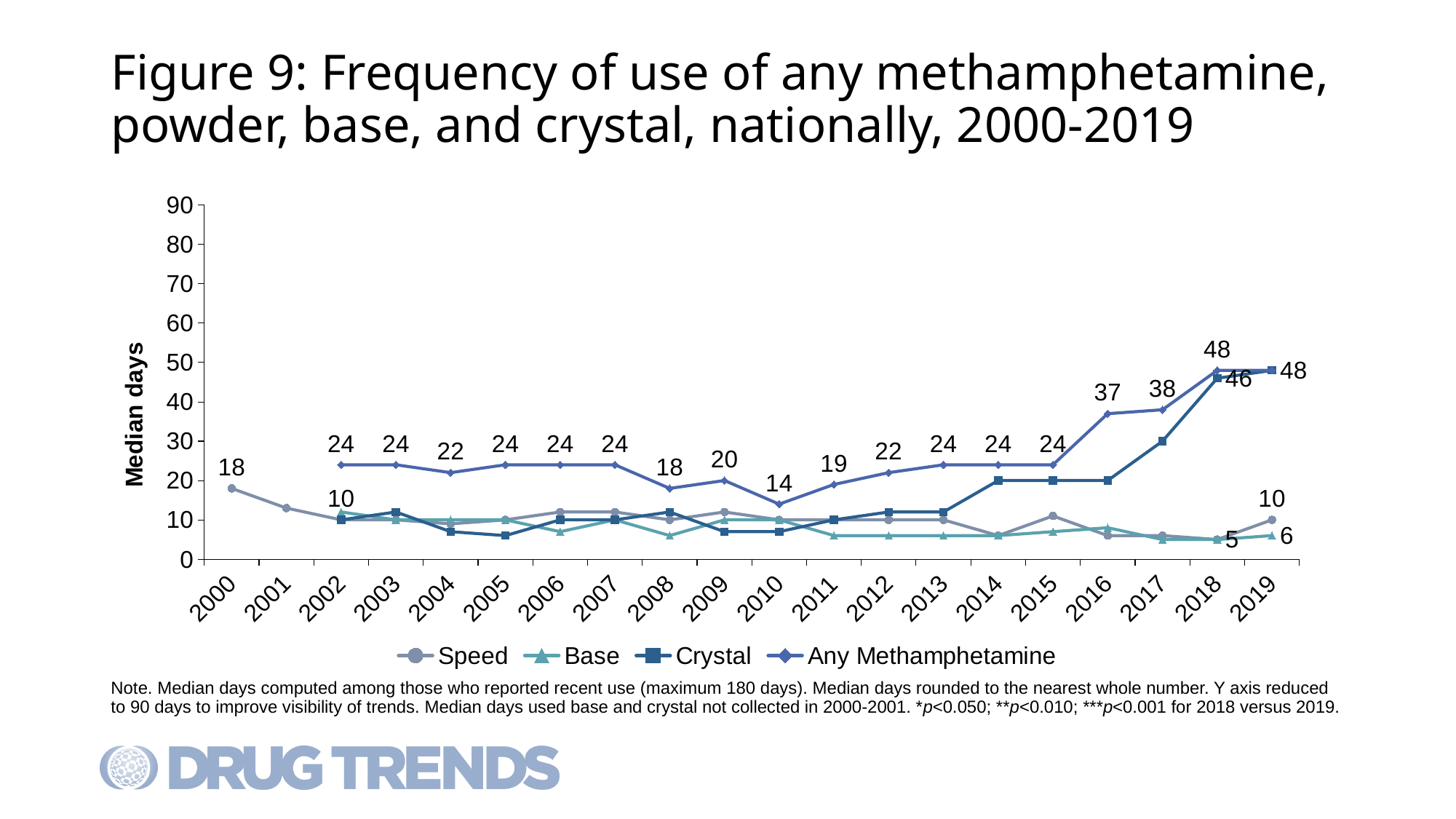
What kind of chart is shown on the slide? Line chart In which year is the Any Methamphetamine value lowest? 2010 What is the median days value for Any Methamphetamine in 2010? 14 Does the Any Methamphetamine line rise or fall from 2015 to 2018? Rise How many series does the legend list? 4 What is the median days value for Any Methamphetamine in 2016? 37 What is the difference between the Any Methamphetamine values in 2018 and 2017? 10 Is the value for Crystal in 2017 greater or less than 20? greater Which is larger, the Any Methamphetamine value in 2016 or in 2010? 2016 What is the median days value for Crystal in 2018? 46 What is the median days value for Base in 2019? 6